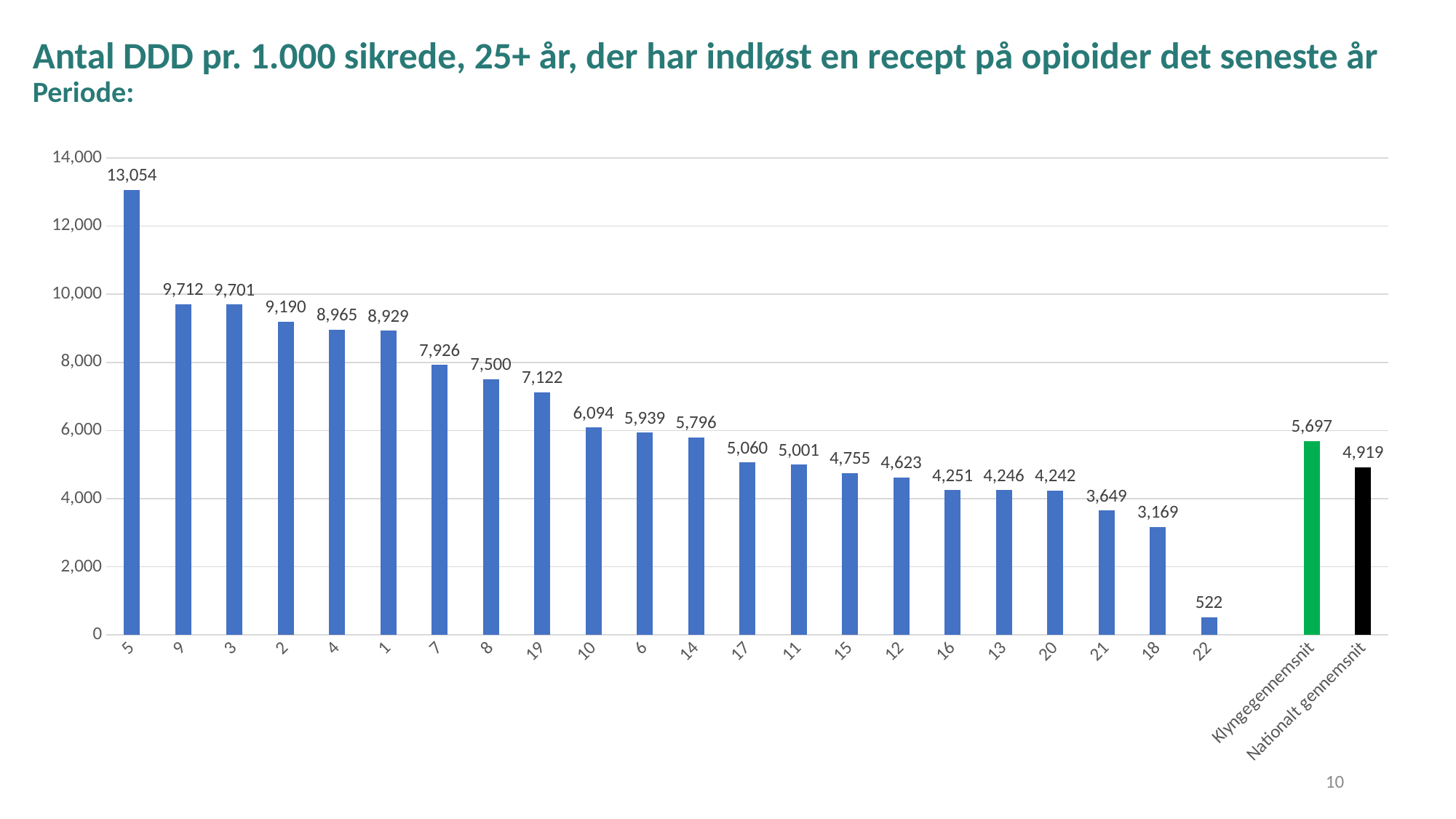
Is the value for category 18 greater or less than 4,000? less What colour is the bar for Klyngegennemsnit? green What is the value for category 22? 522 What kind of chart is shown on the slide? bar chart How many numbered categories are plotted on the chart? 22 What is the value for Nationalt gennemsnit? 4,919 What is the value for category 5? 13,054 What is the difference between the values for Klyngegennemsnit and Nationalt gennemsnit? 778 What is the value for Klyngegennemsnit? 5,697 Which numbered category has the highest value? 5 Which is larger, the value for category 9 or the value for category 2? 9 Which numbered category has the lowest value? 22